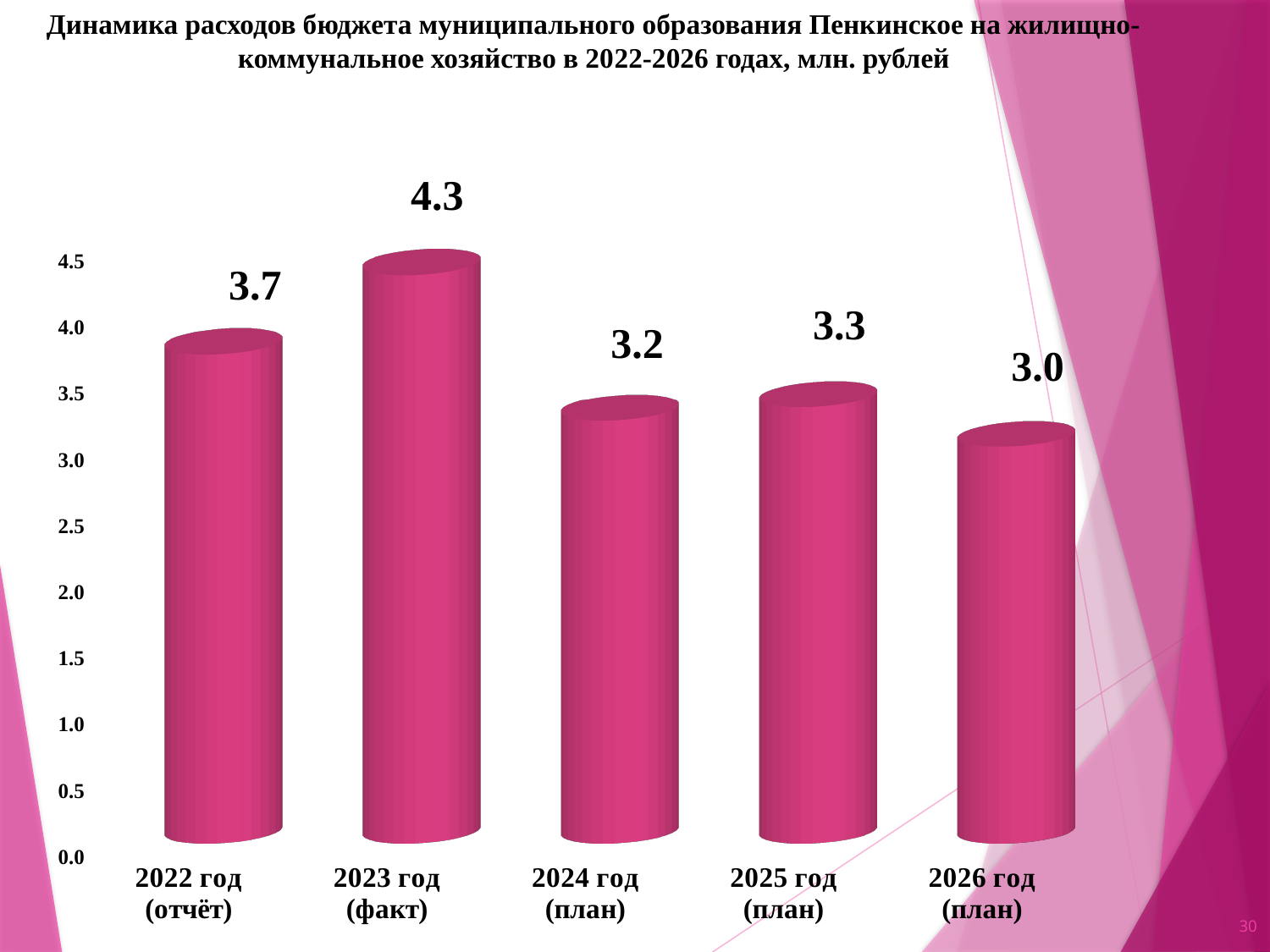
What is the value for 2022 год (отчёт)? 3.7 What is the difference between the values for 2023 год (факт) and 2024 год (план)? 1.1 How many years are shown on the chart? 5 Which year has the lowest value? 2026 год (план) In what units are the values on the chart expressed, according to the title? млн. рублей What kind of chart is shown on the slide? bar chart Which is larger, the value for 2025 год (план) or 2024 год (план)? 2025 год (план) What is the value for 2026 год (план)? 3.0 What is the value for 2023 год (факт)? 4.3 Which year has the highest value? 2023 год (факт) Do the values rise or fall from 2023 год (факт) to 2024 год (план)? fall Is the value for 2022 год (отчёт) greater or less than 3.5? greater